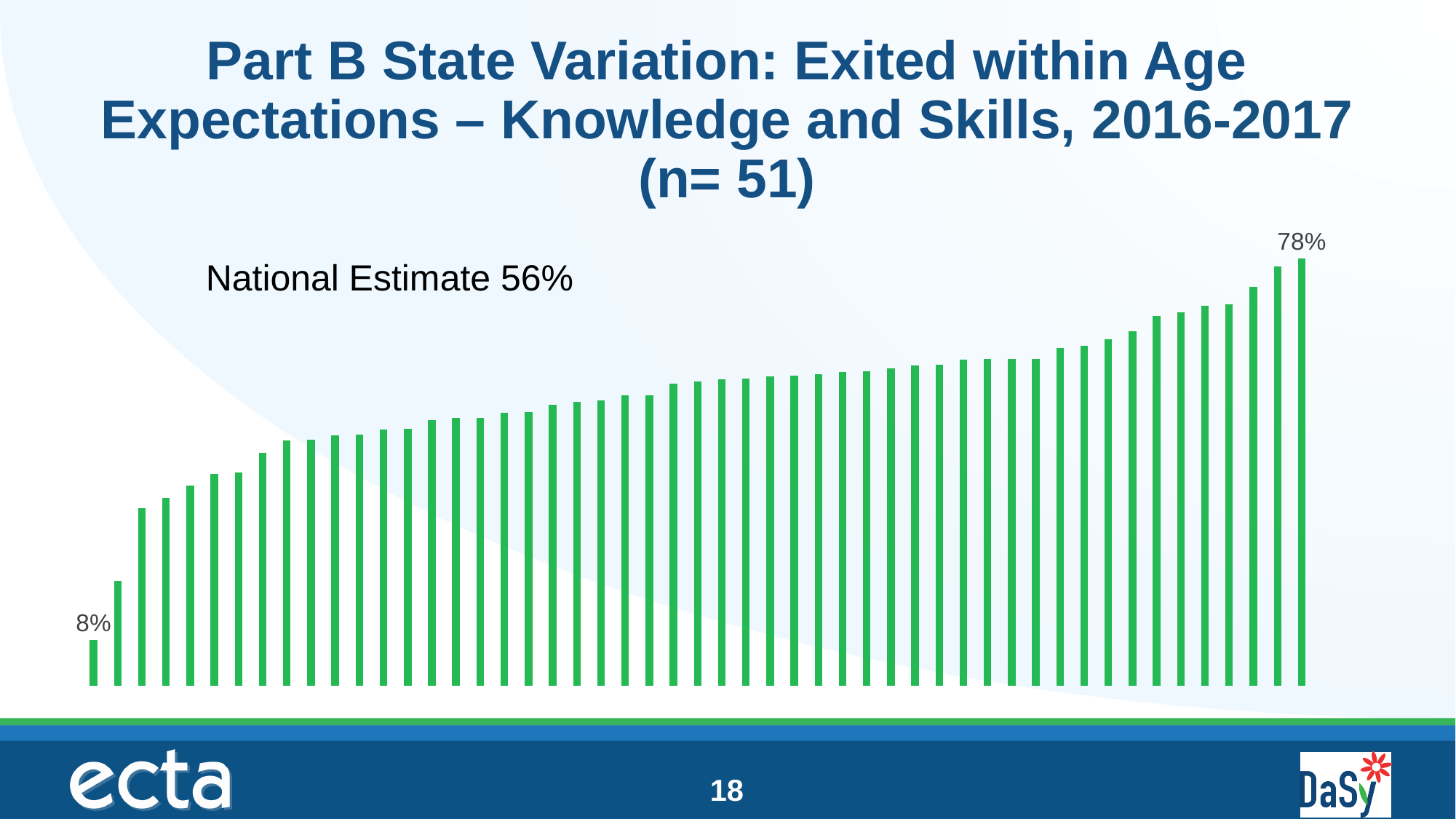
Do the bar values rise or fall from left to right across the chart? rise What is the value labelled on the shortest bar in the chart? 8% What kind of chart is shown on the slide? bar chart Which is larger, the value of the leftmost bar or the value of the rightmost bar? the rightmost bar How many states (n) are represented in the chart, according to the title? 51 What national estimate is stated on the chart? 56% What is the difference between the highest labelled value (78%) and the lowest labelled value (8%) in the chart? 70 percentage points What is the value labelled on the tallest bar in the chart? 78% What colour are the bars in the chart? green